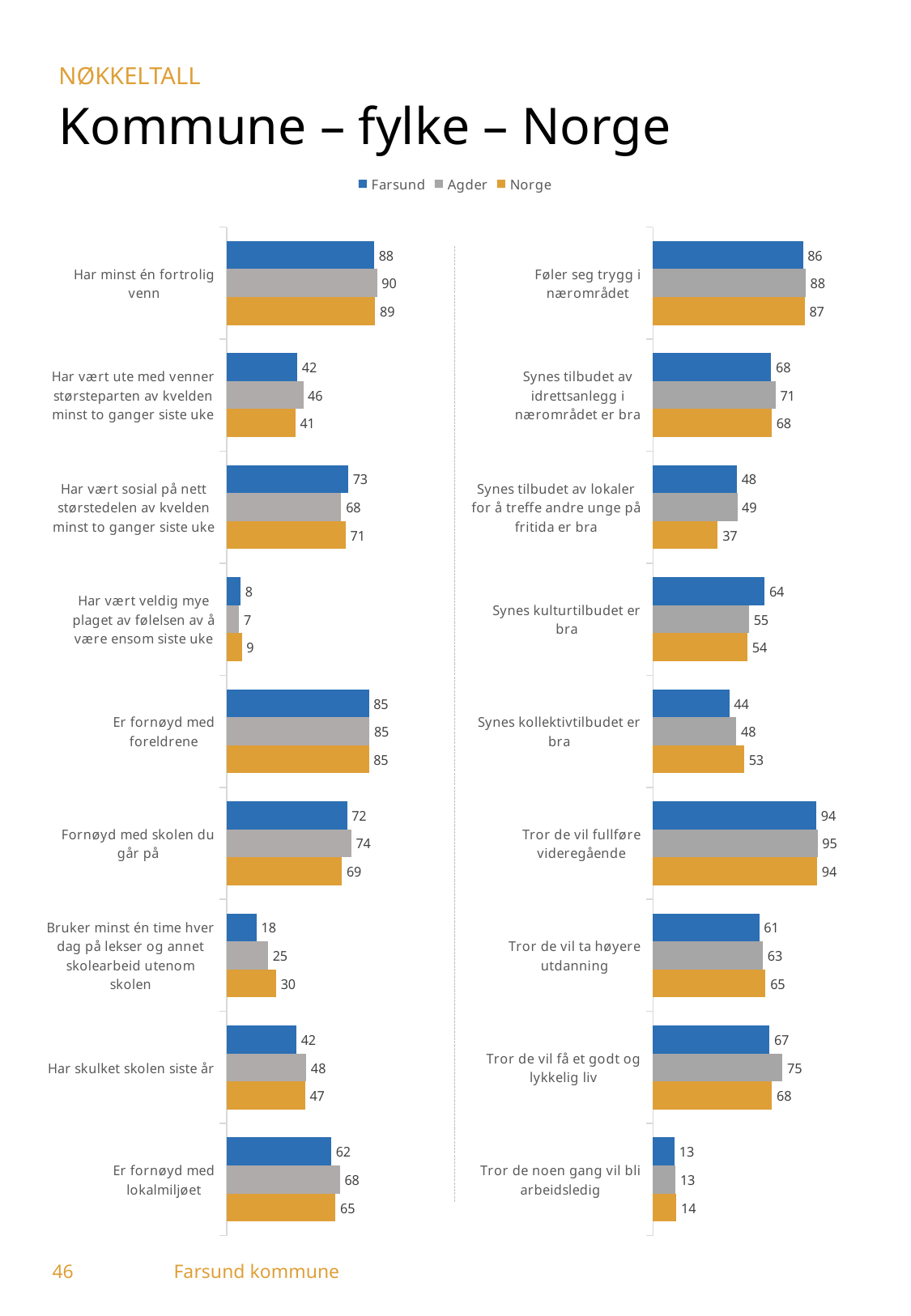
In the right chart, what is the difference between the Agder and Farsund values for "Tror de vil få et godt og lykkelig liv"? 8 In the left chart, what is the Farsund value for "Har minst én fortrolig venn"? 88 In the right chart, which is larger for "Synes kulturtilbudet er bra": the Farsund value or the Norge value? Farsund In the left chart, which is larger for "Har skulket skolen siste år": the Farsund value or the Agder value? Agder What kind of chart is used on this slide? Bar chart In the right chart, what is the Norge value for "Synes tilbudet av lokaler for å treffe andre unge på fritida er bra"? 37 In the left chart, which category has the lowest Norge value? Har vært veldig mye plaget av følelsen av å være ensom siste uke How many series does the legend list? 3 In the left chart, what is the Agder value for "Bruker minst én time hver dag på lekser og annet skolearbeid utenom skolen"? 25 In the right chart, which category has the highest Farsund value? Tror de vil fullføre videregående How many categories does the left chart show? 9 Which series is shown in orange in the legend? Norge